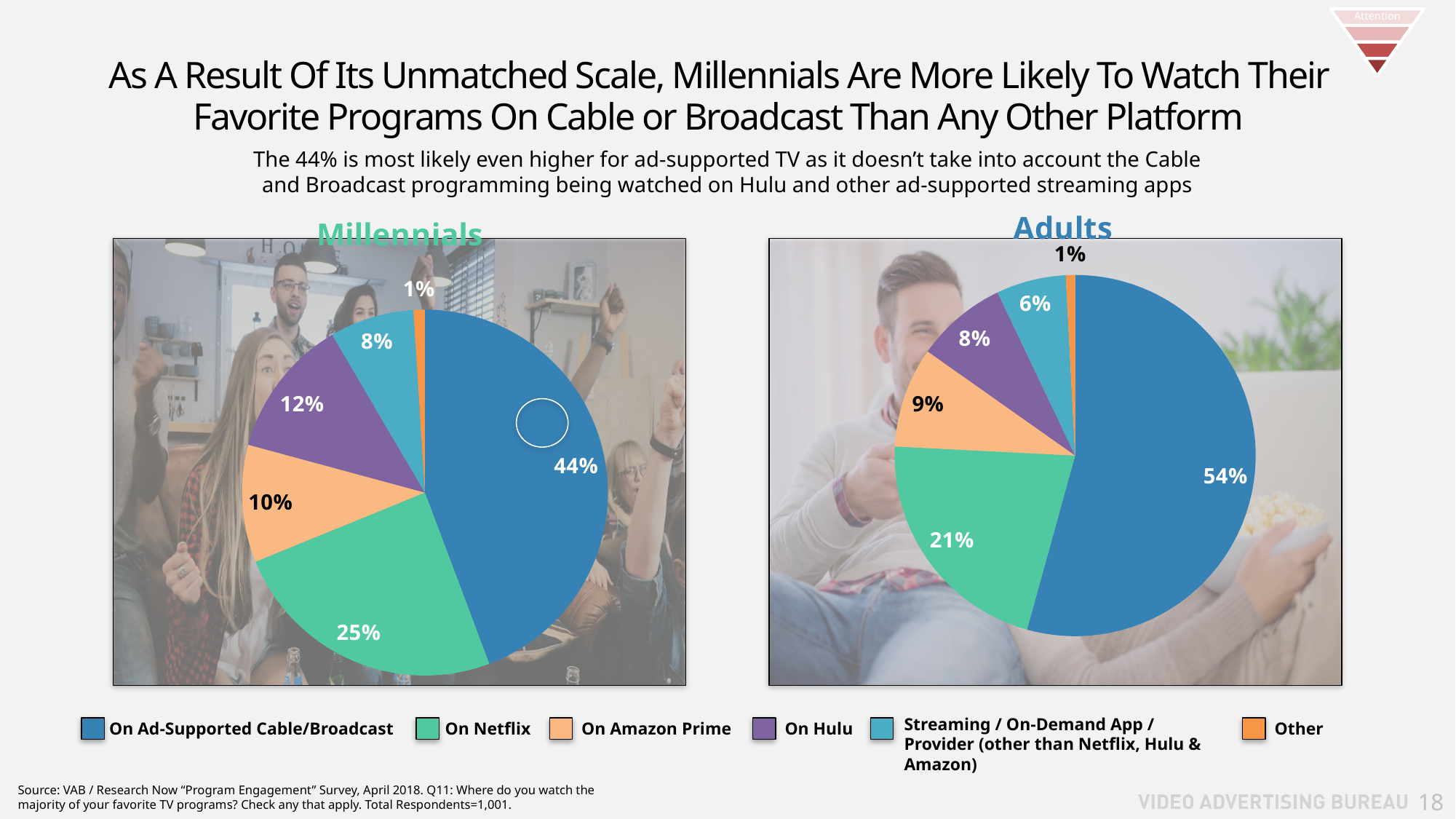
What colour represents On Netflix in the legend? Green How many slices does the Millennials pie chart have? 6 In the Adults pie chart, what share is On Netflix? 21% In the Adults pie chart, what share is On Amazon Prime? 9% In the Millennials pie chart, what share is On Hulu? 12% In the Millennials pie chart, what share is On Ad-Supported Cable/Broadcast? 44% In the Adults pie chart, which category has the largest slice? On Ad-Supported Cable/Broadcast What is the difference between the On Ad-Supported Cable/Broadcast share in the Adults chart and in the Millennials chart? 10% What type of chart is used for the Adults data? Pie chart How many entries does the legend list? 6 Which is larger: the On Hulu share for Millennials or the On Hulu share for Adults? Millennials In the Millennials pie chart, which category has the smallest slice? Other